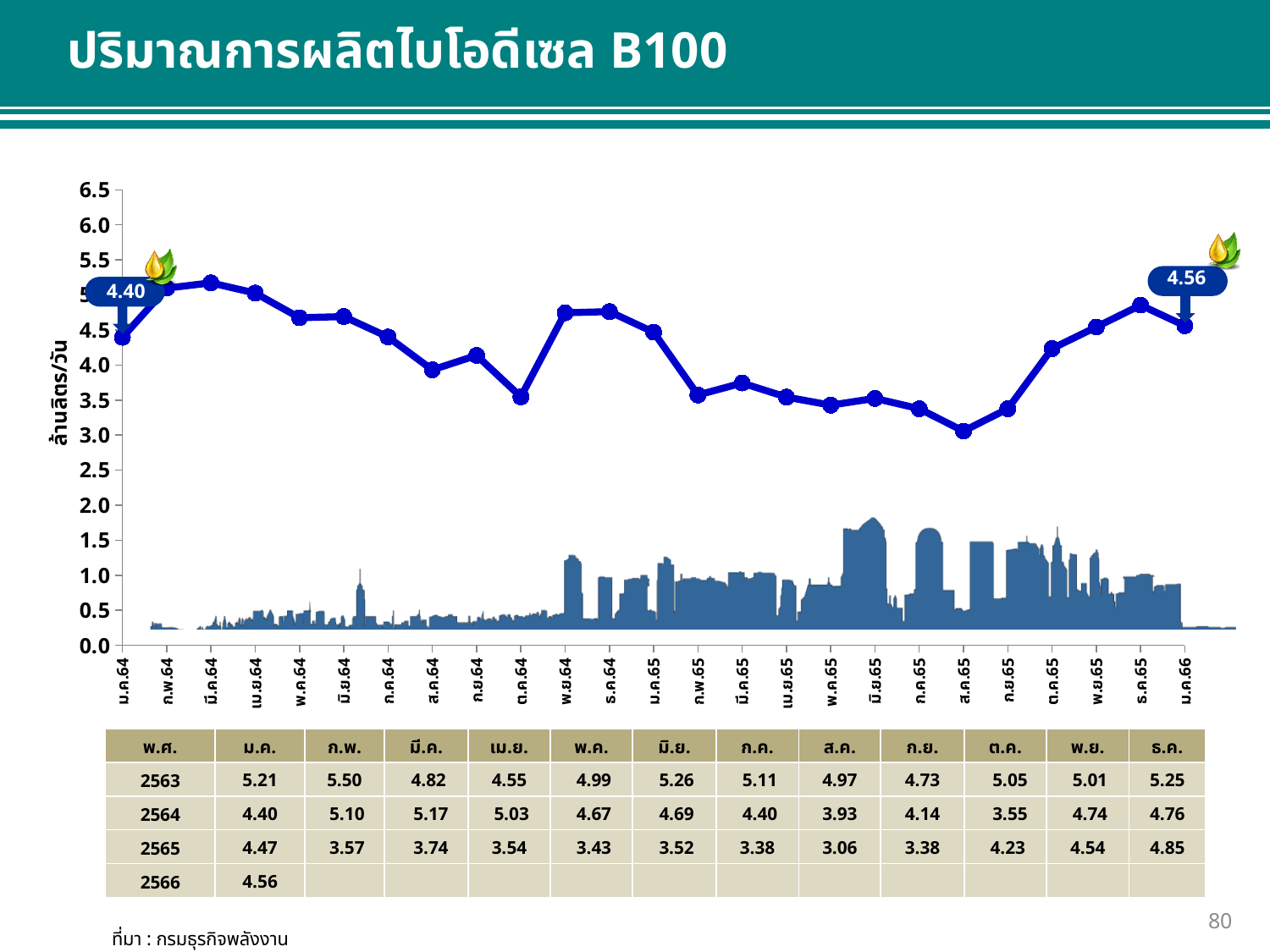
According to the table below the chart, what is the value for ม.ค. in 2563? 5.21 Which is larger, the value at ม.ค.64 or the value at ม.ค.66? ม.ค.66 What is the value labelled at ม.ค.64 on the chart? 4.40 What kind of chart is shown on the slide? line chart What is the difference between the labelled values at ม.ค.66 and ม.ค.64? 0.16 At which month does the line reach its lowest point? ส.ค.65 Does the line rise or fall from ส.ค.65 to ธ.ค.65? rise What is the value labelled at ม.ค.66 on the chart? 4.56 What is the label on the y axis of the chart? ล้านลิตร/วัน Is the value for ต.ค.64 greater or less than 4.0? less How many data points are plotted on the line? 25 Is the value for ส.ค.65 greater or less than 3.5? less